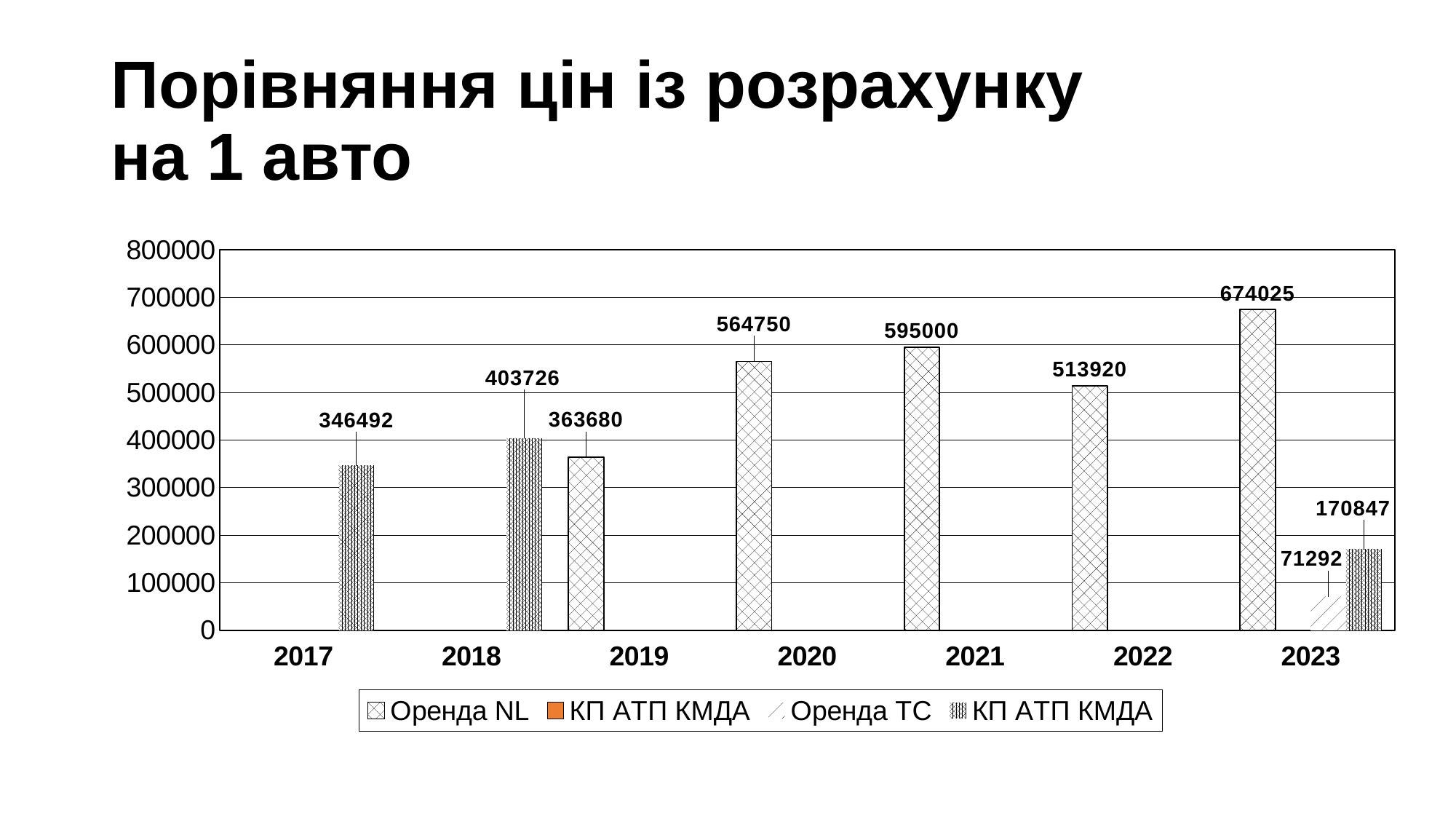
How many years are shown on the x axis? 7 What is the value of the Оренда NL bar for 2023? 674025 What is the highest value labelled on the chart? 674025 What is the value of the КП АТП КМДА bar for 2023? 170847 Is the value of the Оренда NL bar for 2023 greater or less than 600000? greater What is the difference between the Оренда NL value and the КП АТП КМДА value for 2023? 503178 What is the value of the Оренда ТС bar for 2023? 71292 What is the title of the chart? Порівняння цін із розрахунку на 1 авто How many series does the legend list? 4 What kind of chart is shown on the slide? bar chart What is the lowest value labelled on the chart? 71292 What is the value of the bar for 2017? 346492